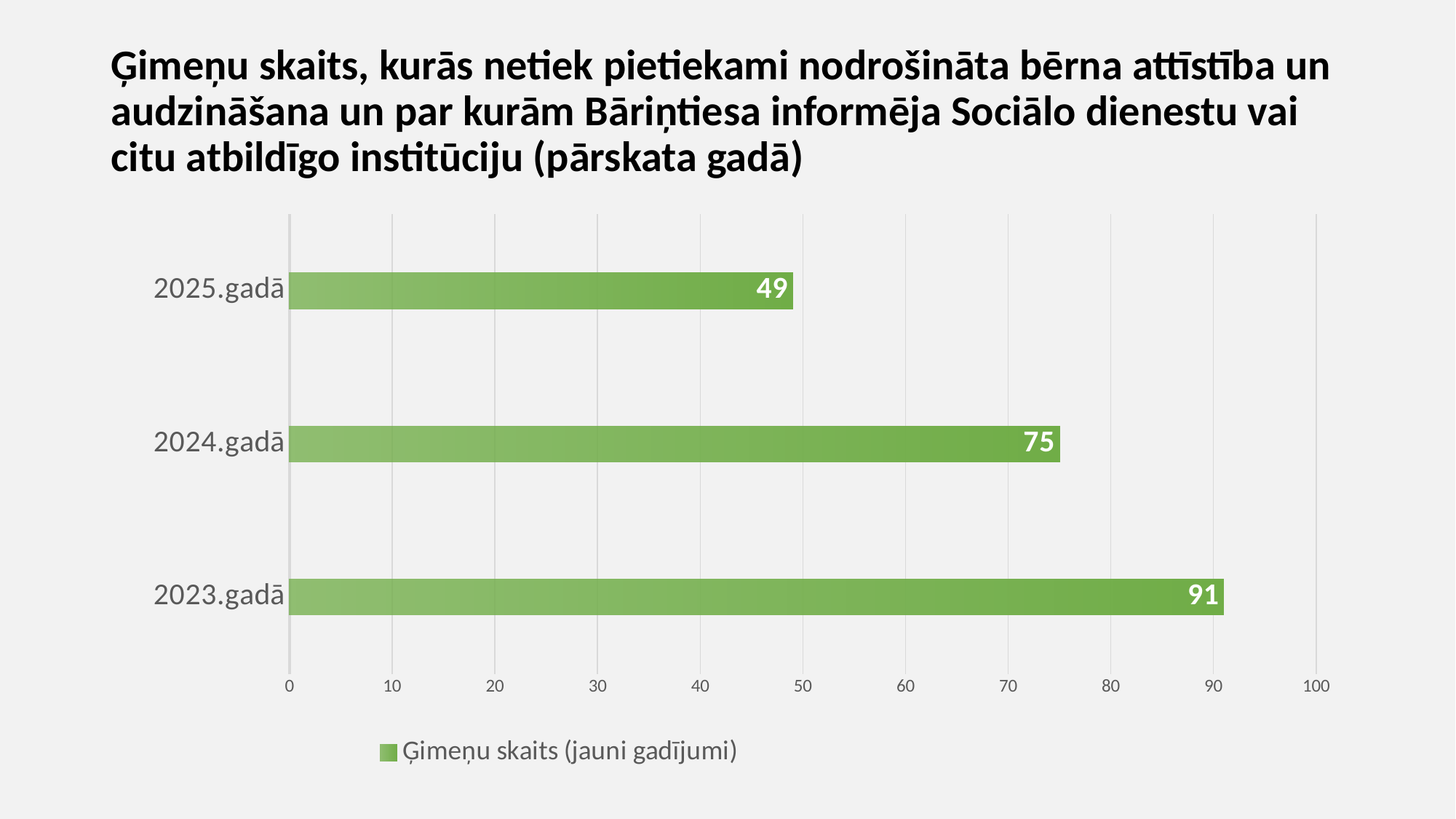
What is the legend entry for the series shown in the chart? Ģimeņu skaits (jauni gadījumi) Which is larger, the value for 2024.gadā or the value for 2025.gadā? 2024.gadā Which year has the highest value? 2023.gadā What kind of chart is shown on the slide? bar chart What is the difference between the values for 2023.gadā and 2025.gadā? 42 What is the difference between the values for 2024.gadā and 2025.gadā? 26 Is the value for 2023.gadā greater or less than 80? greater What is the value for 2023.gadā? 91 What is the value for 2024.gadā? 75 Which year has the lowest value? 2025.gadā What is the value for 2025.gadā? 49 How many years are shown in the chart? 3